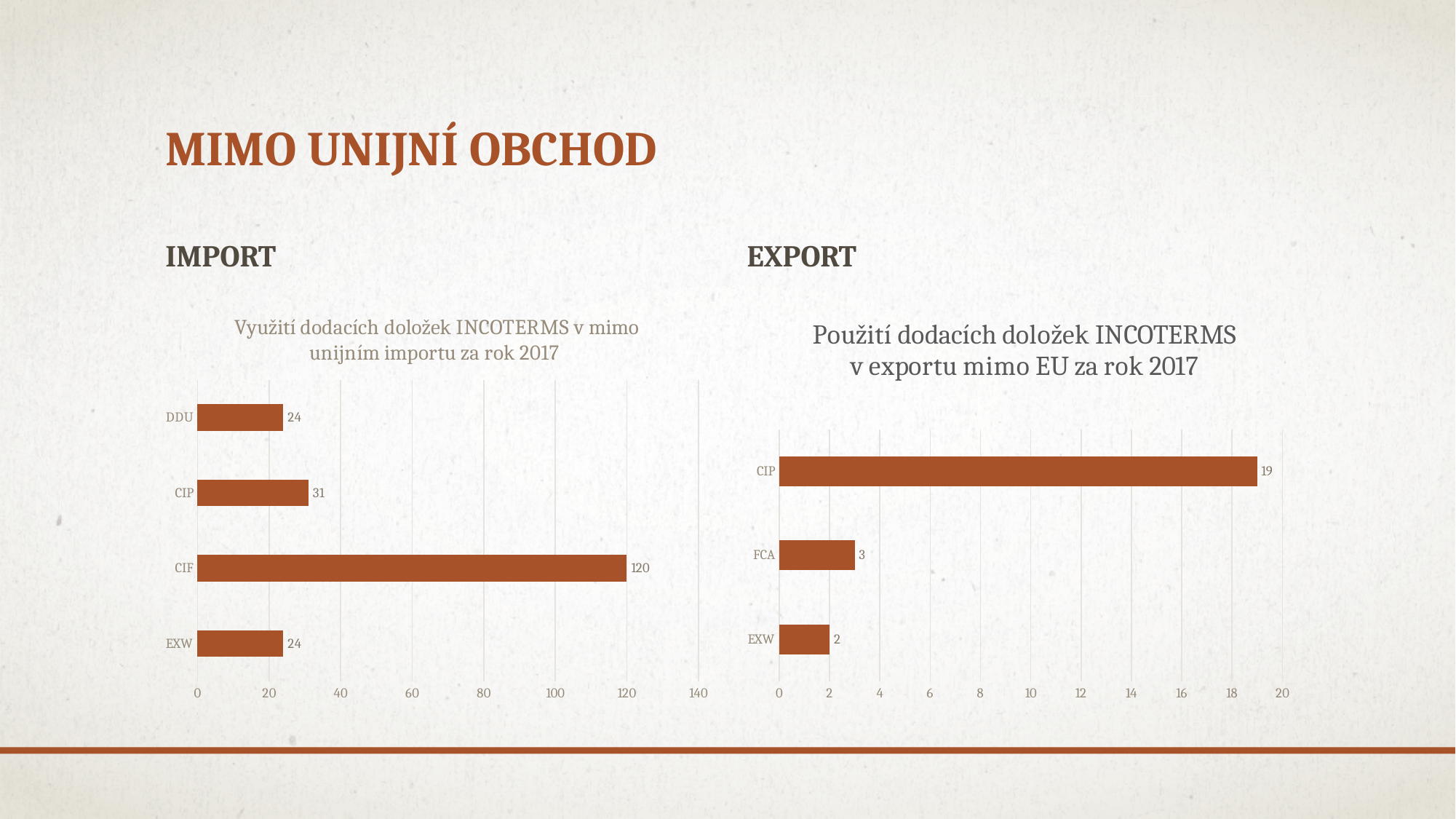
What kind of chart is the EXPORT chart? Bar chart In the IMPORT chart, how many categories are shown? 4 In the IMPORT chart, what is the value for CIP? 31 In the EXPORT chart, what is the value for EXW? 2 In the IMPORT chart, which category has the highest value? CIF In the EXPORT chart, how many categories are shown? 3 In the IMPORT chart, is the value for CIF greater or less than 100? greater In the EXPORT chart, what is the value for CIP? 19 In the EXPORT chart, which is larger, the value for FCA or the value for EXW? FCA In the IMPORT chart, what is the value for CIF? 120 In the IMPORT chart, what is the difference between the values for CIF and CIP? 89 In the EXPORT chart, which category has the lowest value? EXW